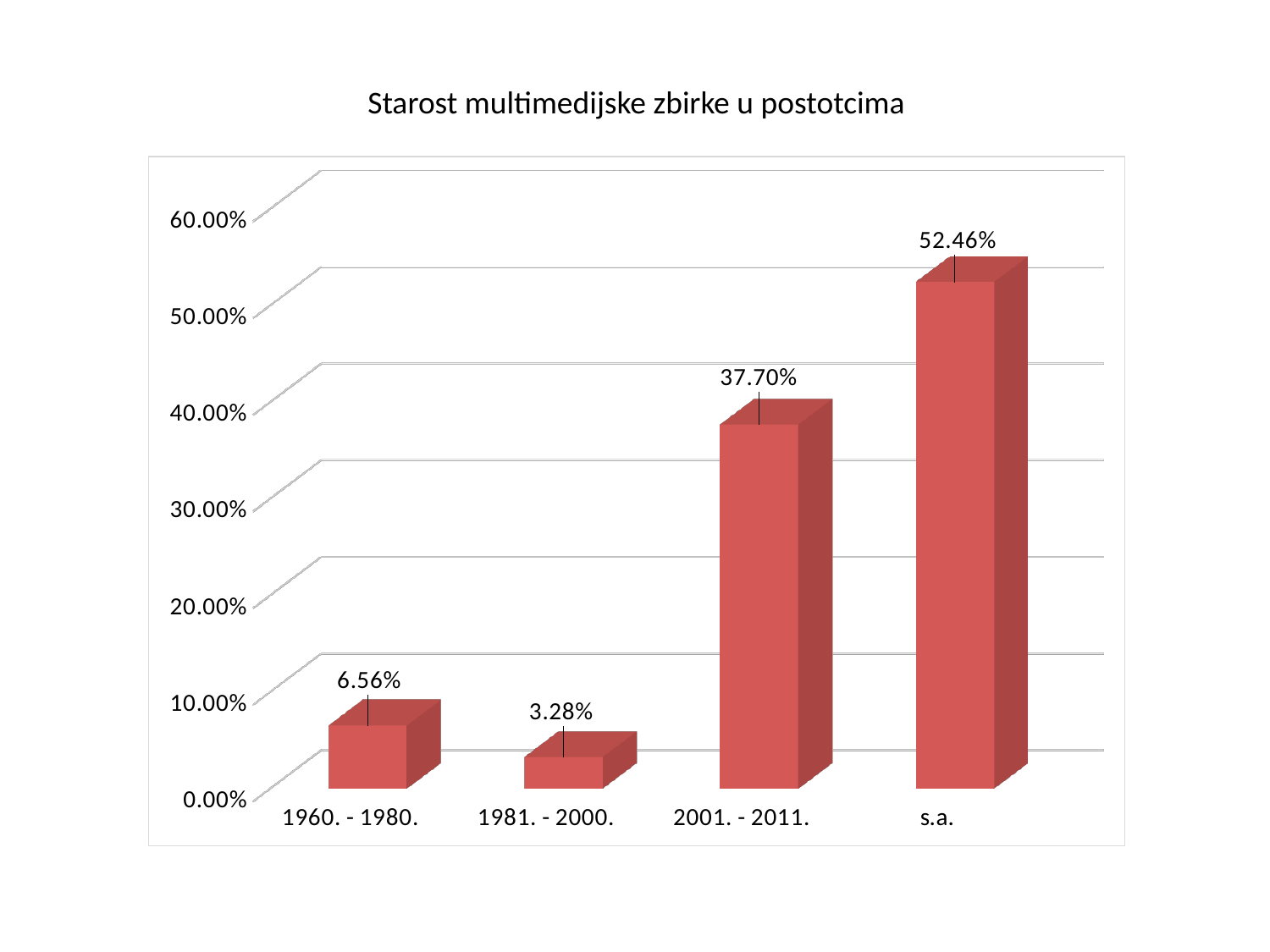
What is the title of the chart? Starost multimedijske zbirke u postotcima What is the value for 2001. - 2011.? 37.70% What is the difference between the values for s.a. and 2001. - 2011.? 14.76% What kind of chart is this? bar chart What is the difference between the values for 1960. - 1980. and 1981. - 2000.? 3.28% What is the value for 1960. - 1980.? 6.56% How many categories are shown on the x axis? 4 Which category has the lowest value? 1981. - 2000. What is the value for s.a.? 52.46% Which is larger, the value for 1960. - 1980. or the value for 1981. - 2000.? 1960. - 1980. What is the value for 1981. - 2000.? 3.28% Which category has the highest value? s.a.